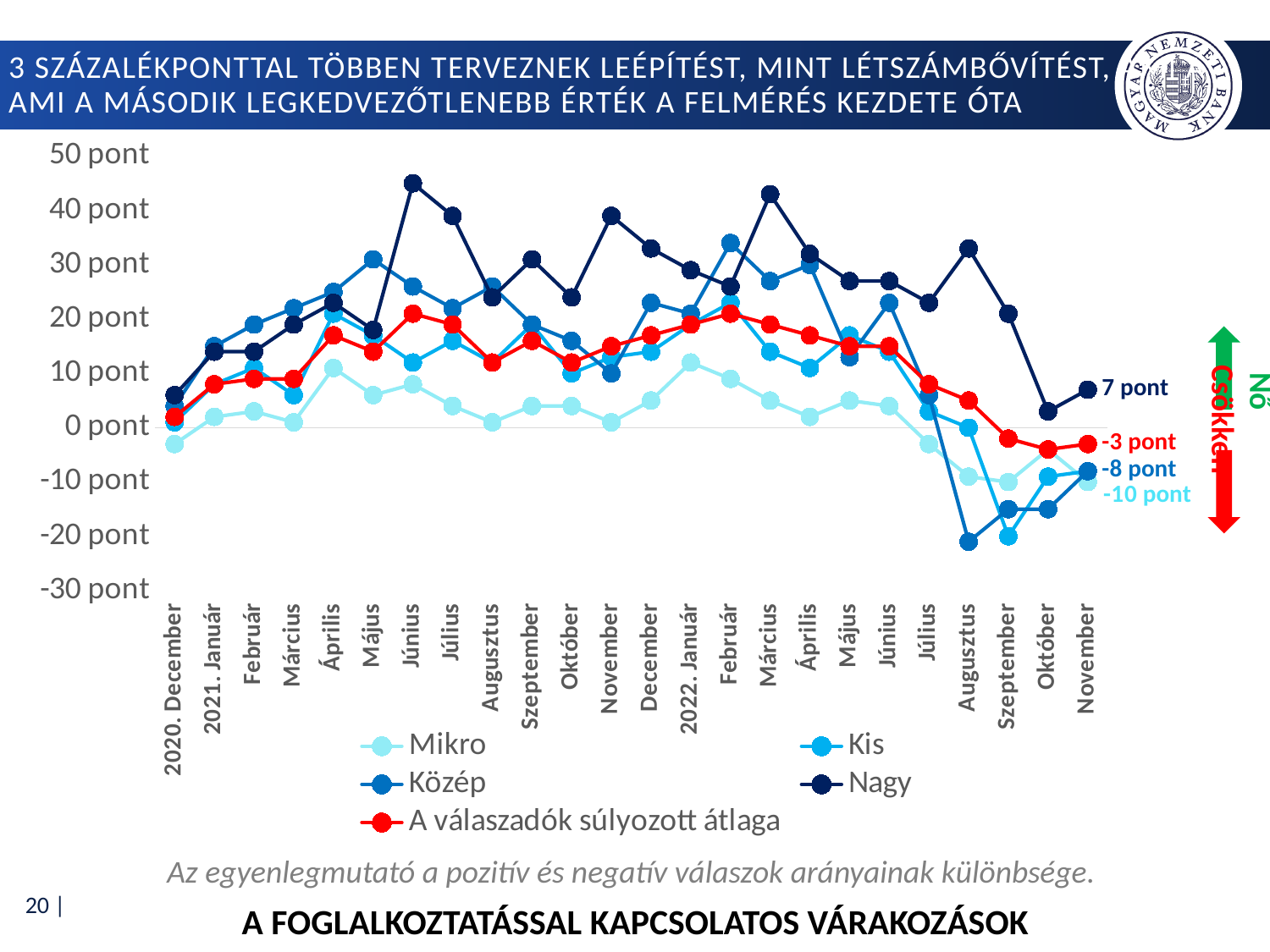
What is the value for 'A válaszadók súlyozott átlaga' in 2022 November? -3 pont How many series does the legend list? 5 Is the value for Nagy in 2021 Június greater or less than 40 pont? greater What is the value for the Mikro series in 2022 November? -10 pont Is the value for Közép in 2022 Augusztus greater or less than -10 pont? less Does the Nagy series rise or fall from 2022 Augusztus to 2022 Október? fall What kind of chart is shown on the slide? line chart Which series has the lowest value in 2022 Augusztus? Közép What is the value for the Nagy series in 2022 November? 7 pont Which series has the highest value in 2022 November? Nagy What is the difference between the Nagy value and the 'A válaszadók súlyozott átlaga' value in 2022 November? 10 pont How many months are plotted along the x axis? 24